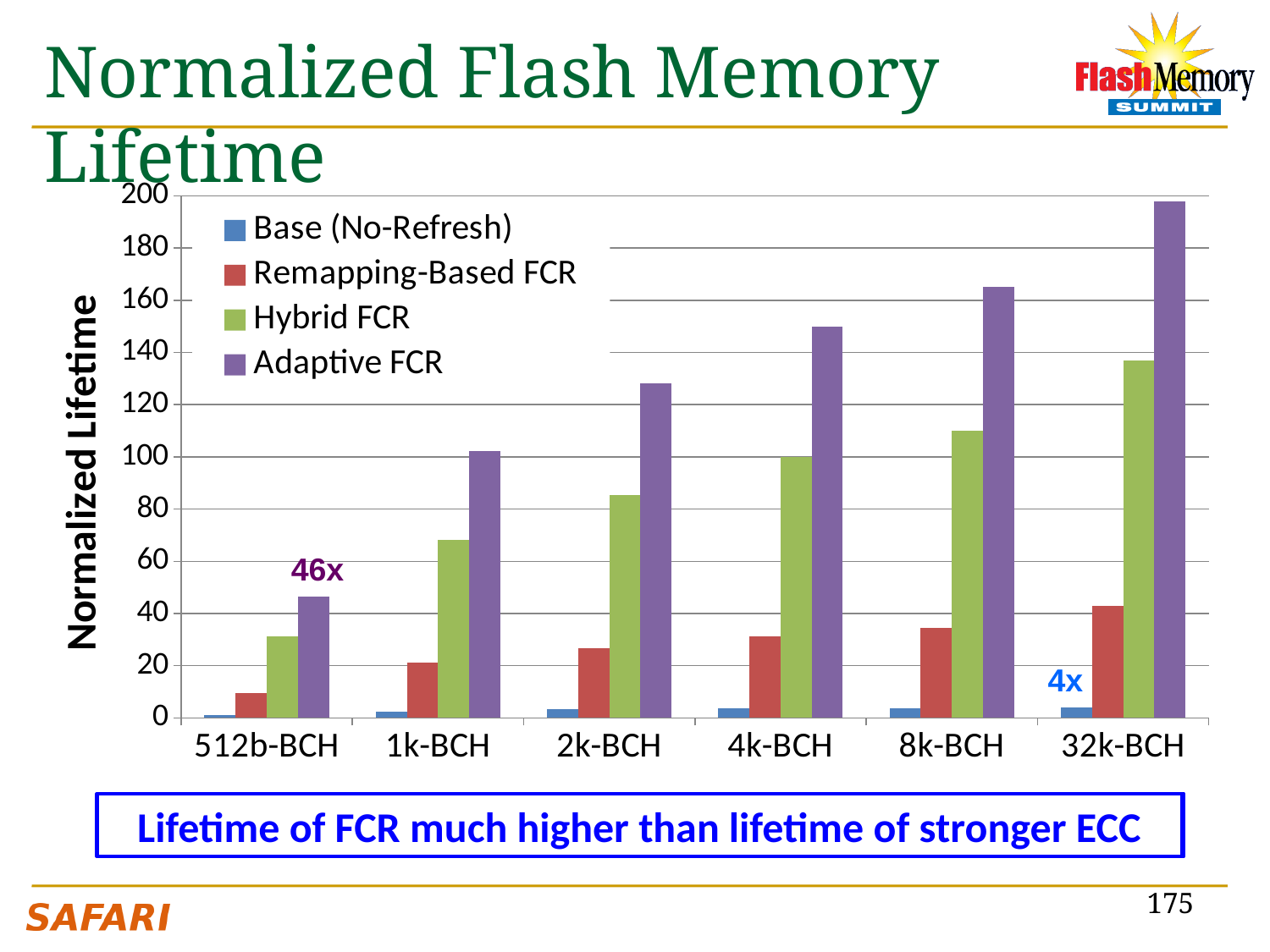
Which category has the highest Adaptive FCR value? 32k-BCH Is the Adaptive FCR value for 2k-BCH greater or less than 120? greater What label is printed above the Adaptive FCR bar at 512b-BCH? 46x What kind of chart is shown on the slide? bar chart Do the Adaptive FCR values rise or fall from 512b-BCH to 32k-BCH? rise What is the title of the y axis? Normalized Lifetime How many series does the legend list? 4 Is the Hybrid FCR value for 2k-BCH greater or less than 100? less At 8k-BCH, which is larger: Hybrid FCR or Remapping-Based FCR? Hybrid FCR Which category has the lowest Adaptive FCR value? 512b-BCH How many ECC configurations (categories) are shown on the x axis? 6 Is the Adaptive FCR value for 4k-BCH greater or less than 140? greater